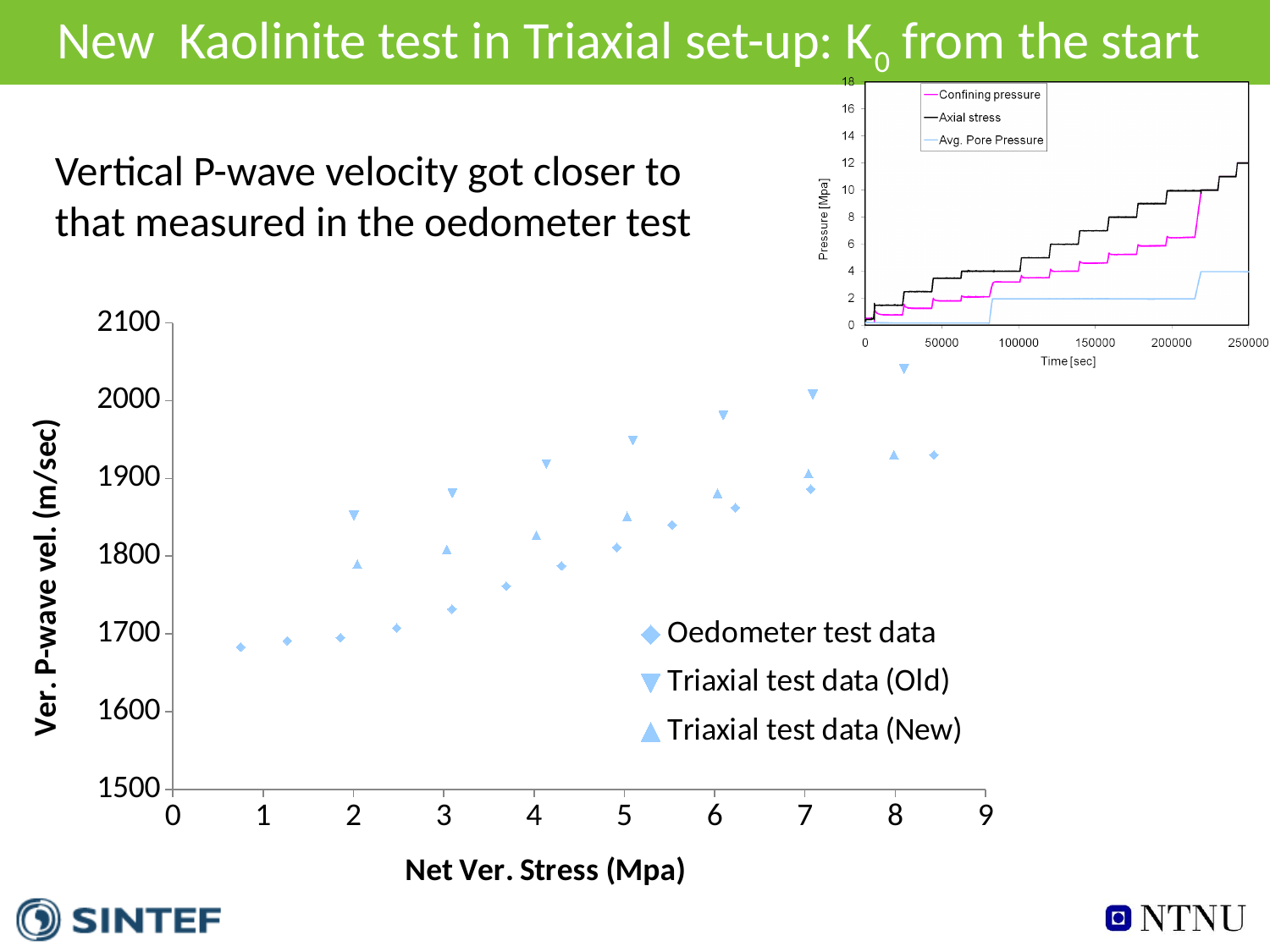
In the large P-wave velocity chart, is the lowest Oedometer test data point greater or less than 1700 m/sec? less In the large P-wave velocity chart, do the P-wave velocities rise or fall as Net Ver. Stress increases? rise How many series does the legend of the small inset Pressure chart list? 3 In the large P-wave velocity chart, which series contains the highest plotted point? Triaxial test data (Old) How many Triaxial test data (Old) points are plotted in the large P-wave velocity chart? 7 In the small inset Pressure chart, which series has the highest values throughout? Axial stress In the large P-wave velocity chart, which series is plotted with downward-pointing triangles? Triaxial test data (Old) What type of chart is the large chart of Ver. P-wave vel. against Net Ver. Stress? scatter chart What type of chart is the small inset chart of Pressure against Time? line chart How many series does the legend of the large P-wave velocity chart list? 3 In the large P-wave velocity chart, at about 8 Mpa, which is larger: the Triaxial test data (Old) value or the Triaxial test data (New) value? Triaxial test data (Old) In the large P-wave velocity chart, is the Triaxial test data (Old) value at about 8 Mpa greater or less than 2000 m/sec? greater